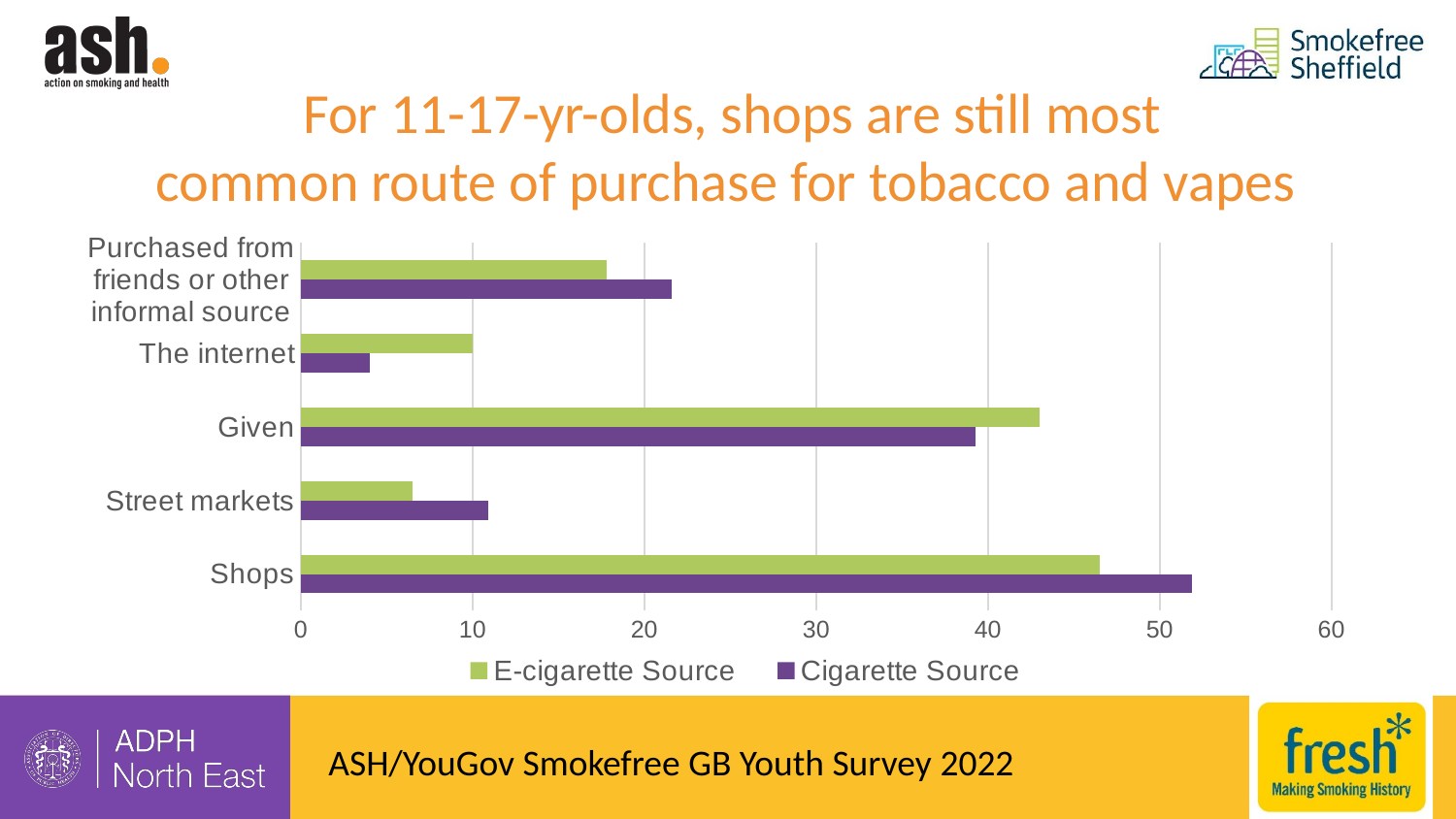
Which series is shown in purple in the legend? Cigarette Source How many categories are shown on the chart? 5 Is the Cigarette Source value for Shops greater or less than 50? greater Which category has the highest value for E-cigarette Source? Shops For Shops, which is larger: the E-cigarette Source value or the Cigarette Source value? Cigarette Source Which category has the lowest value for E-cigarette Source? Street markets Which category has the lowest value for Cigarette Source? The internet How many series does the legend list? 2 For The internet, which is larger: the E-cigarette Source value or the Cigarette Source value? E-cigarette Source Is the E-cigarette Source value for Given greater or less than 40? greater What kind of chart is shown on the slide? bar chart Which category has the highest value for Cigarette Source? Shops